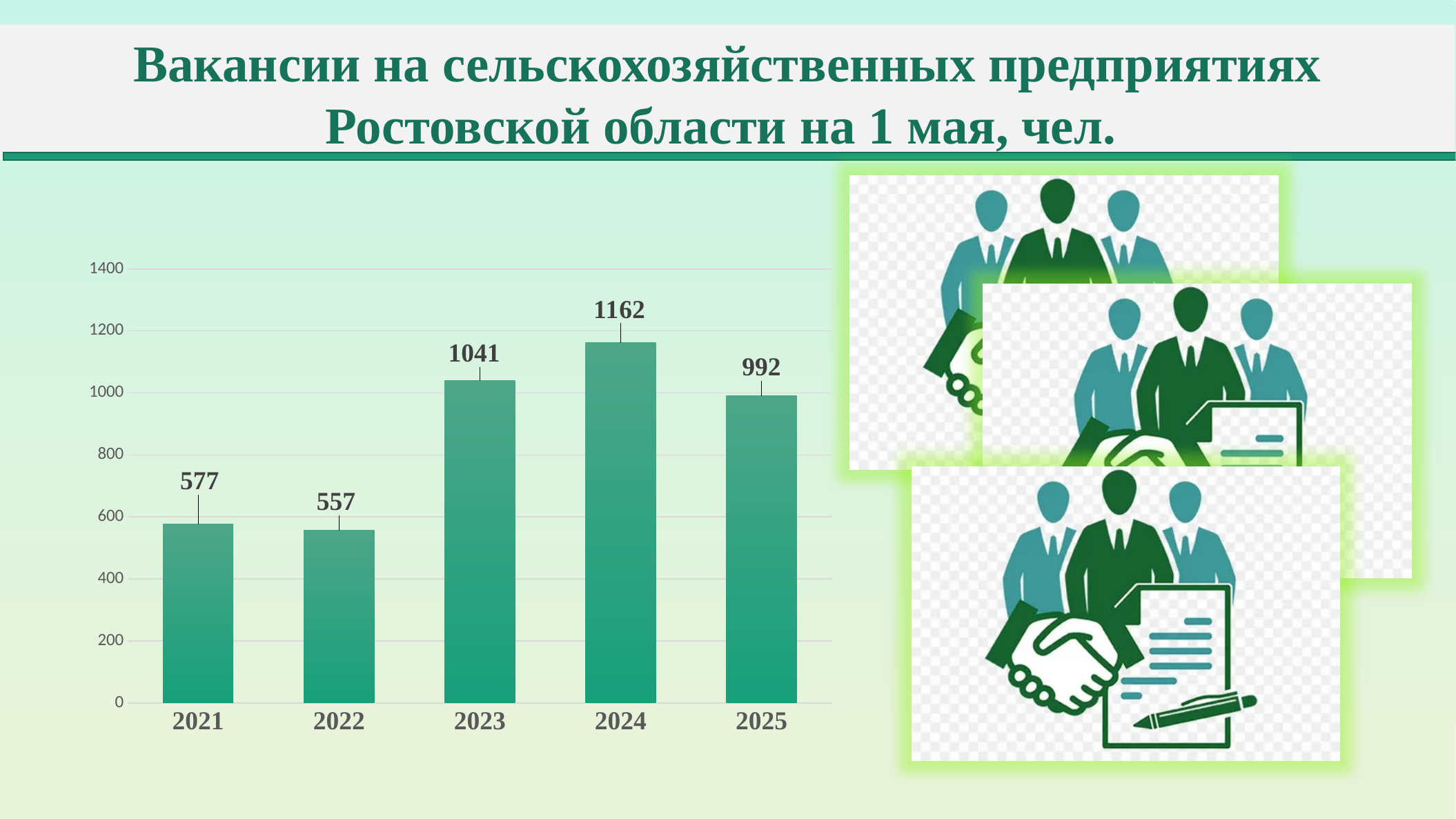
Does the value rise or fall from 2024 to 2025? fall What is the value for 2025? 992 Which year has the lowest value? 2022 Which is larger, the value for 2023 or the value for 2025? 2023 What is the value for 2021? 577 Which year has the highest value? 2024 What is the difference between the values for 2021 and 2022? 20 What is the value for 2024? 1162 How many years are shown on the x axis? 5 What kind of chart is shown on the slide? bar chart What is the difference between the values for 2024 and 2023? 121 Is the value for 2023 greater or less than 1000? greater